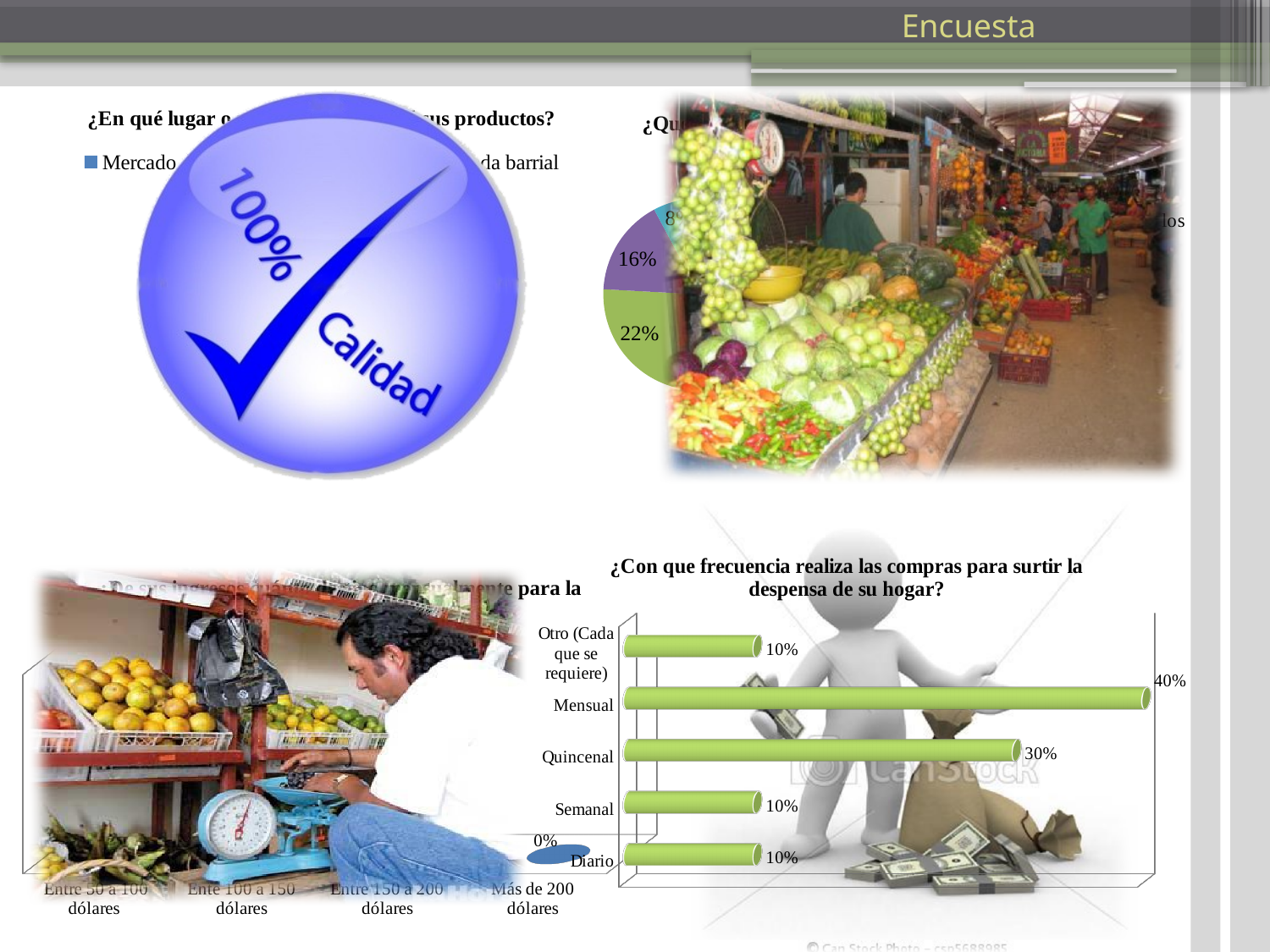
What kind of chart is the one titled '¿Con que frecuencia realiza las compras para surtir la despensa de su hogar?'? bar chart In the chart titled '¿Con que frecuencia realiza las compras para surtir la despensa de su hogar?', what is the value for 'Otro (Cada que se requiere)'? 10% In the chart titled '¿Con que frecuencia realiza las compras para surtir la despensa de su hogar?', what is the value for Quincenal? 30% How many categories are labelled on the x axis of the bottom-left chart (the one with categories in dólares)? 4 How many categories are shown in the chart titled '¿Con que frecuencia realiza las compras para surtir la despensa de su hogar?'? 5 In the chart titled '¿Con que frecuencia realiza las compras para surtir la despensa de su hogar?', which is larger, Quincenal or Semanal? Quincenal In the chart titled '¿Con que frecuencia realiza las compras para surtir la despensa de su hogar?', which category has the highest value? Mensual In the chart titled '¿Con que frecuencia realiza las compras para surtir la despensa de su hogar?', what is the value for Mensual? 40% In the chart titled '¿Con que frecuencia realiza las compras para surtir la despensa de su hogar?', what is the difference between the values for Mensual and Quincenal? 10% In the chart titled '¿Con que frecuencia realiza las compras para surtir la despensa de su hogar?', what is the value for Semanal? 10% In the chart titled '¿Con que frecuencia realiza las compras para surtir la despensa de su hogar?', what is the total of all the labelled values? 100% In the chart titled '¿Con que frecuencia realiza las compras para surtir la despensa de su hogar?', what is the value for Diario? 10%